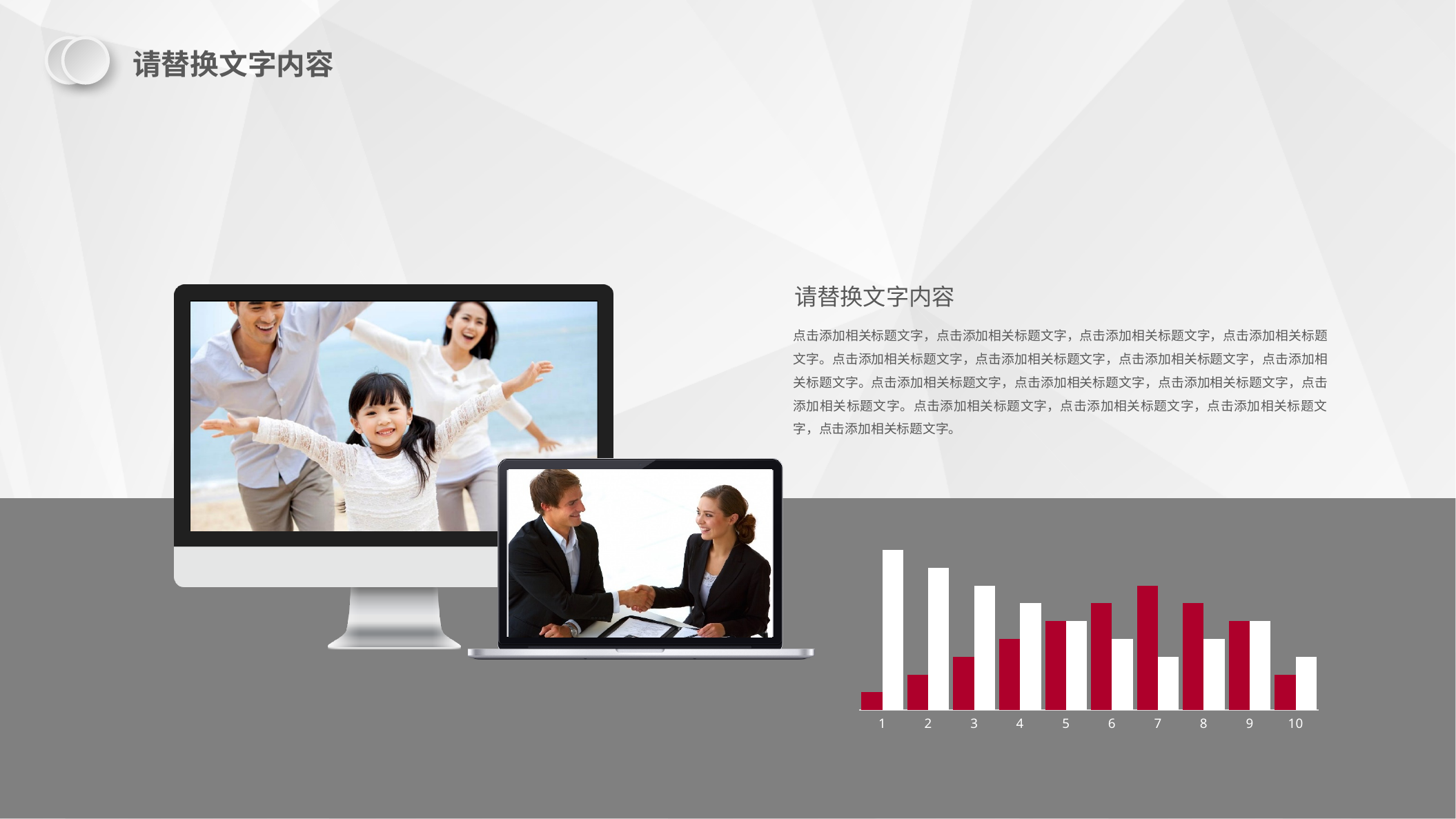
How many bars are plotted for each category in the bar chart? 2 How many categories are shown on the x axis of the bar chart? 10 Do the white bars rise or fall from category 1 to category 4? Fall What two colours are used for the bars in the chart? Red and white Which category has the tallest red bar in the bar chart? 7 Do the red bars rise or fall from category 1 to category 7? Rise In category 1, which bar is taller, the red one or the white one? White Which category has the shortest red bar in the bar chart? 1 In category 7, which bar is taller, the red one or the white one? Red In category 10, which bar is taller, the red one or the white one? White What kind of chart is shown at the bottom right of the slide? Bar chart Which category has the tallest white bar in the bar chart? 1